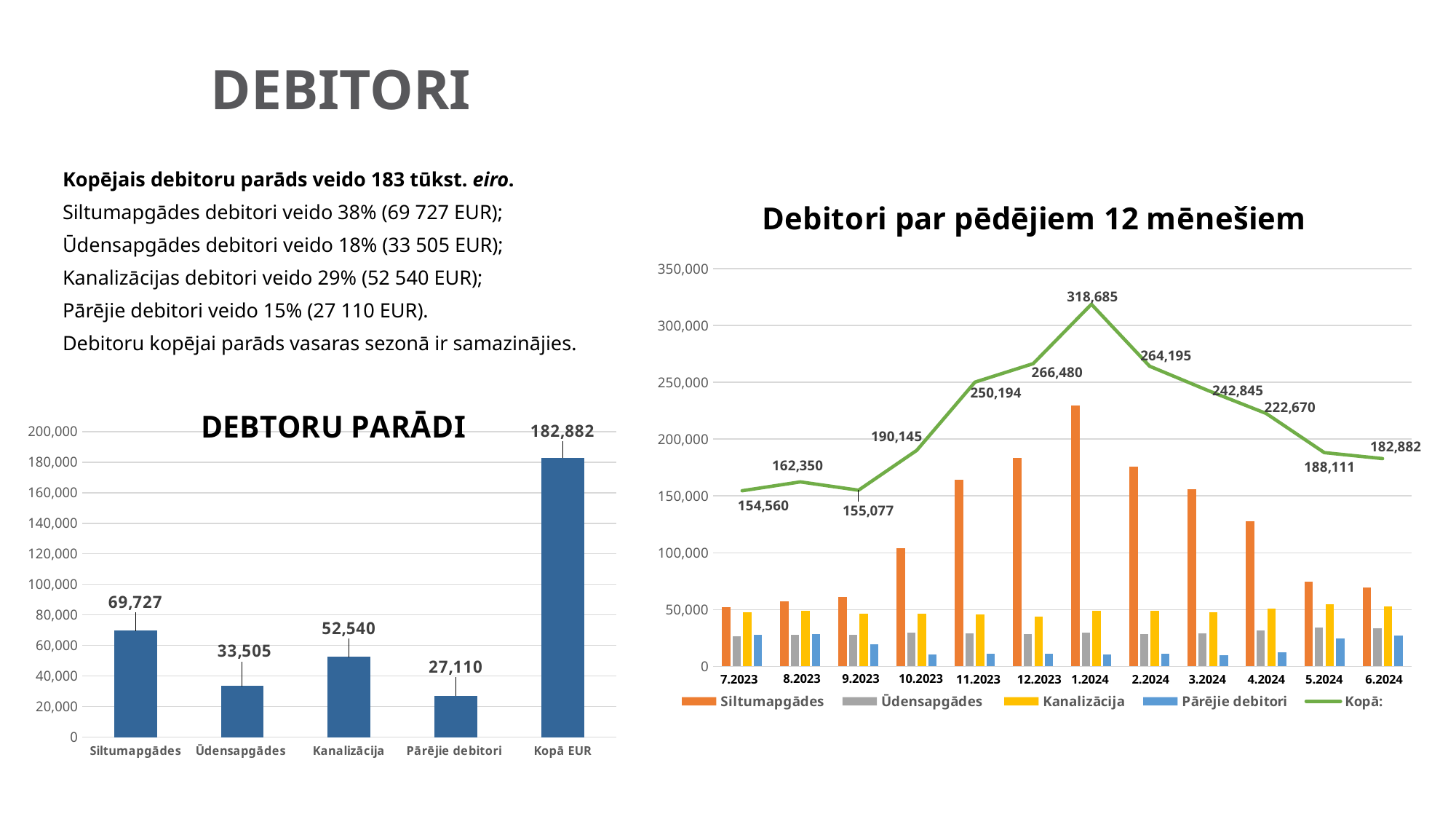
In the chart Debitori par pēdējiem 12 mēnešiem, what is the Kopā value for 7.2023? 154,560 In the DEBTORU PARĀDI chart, what is the value for Kanalizācija? 52,540 In the chart Debitori par pēdējiem 12 mēnešiem, how many series does the legend list? 5 In the DEBTORU PARĀDI chart, what is the difference between Siltumapgādes and Ūdensapgādes? 36,222 In the DEBTORU PARĀDI chart, which category other than Kopā EUR has the highest value? Siltumapgādes In the chart Debitori par pēdējiem 12 mēnešiem, what is the Kopā value for 1.2024? 318,685 In the DEBTORU PARĀDI chart, which category has the lowest value? Pārējie debitori In the DEBTORU PARĀDI chart, what is the value for Pārējie debitori? 27,110 In the chart Debitori par pēdējiem 12 mēnešiem, does the Kopā line rise or fall from 1.2024 to 6.2024? fall In the chart Debitori par pēdējiem 12 mēnešiem, is the Siltumapgādes value for 1.2024 greater or less than 200,000? greater In the chart Debitori par pēdējiem 12 mēnešiem, in which month is the Kopā line at its lowest? 7.2023 In the DEBTORU PARĀDI chart, how many bars are shown? 5